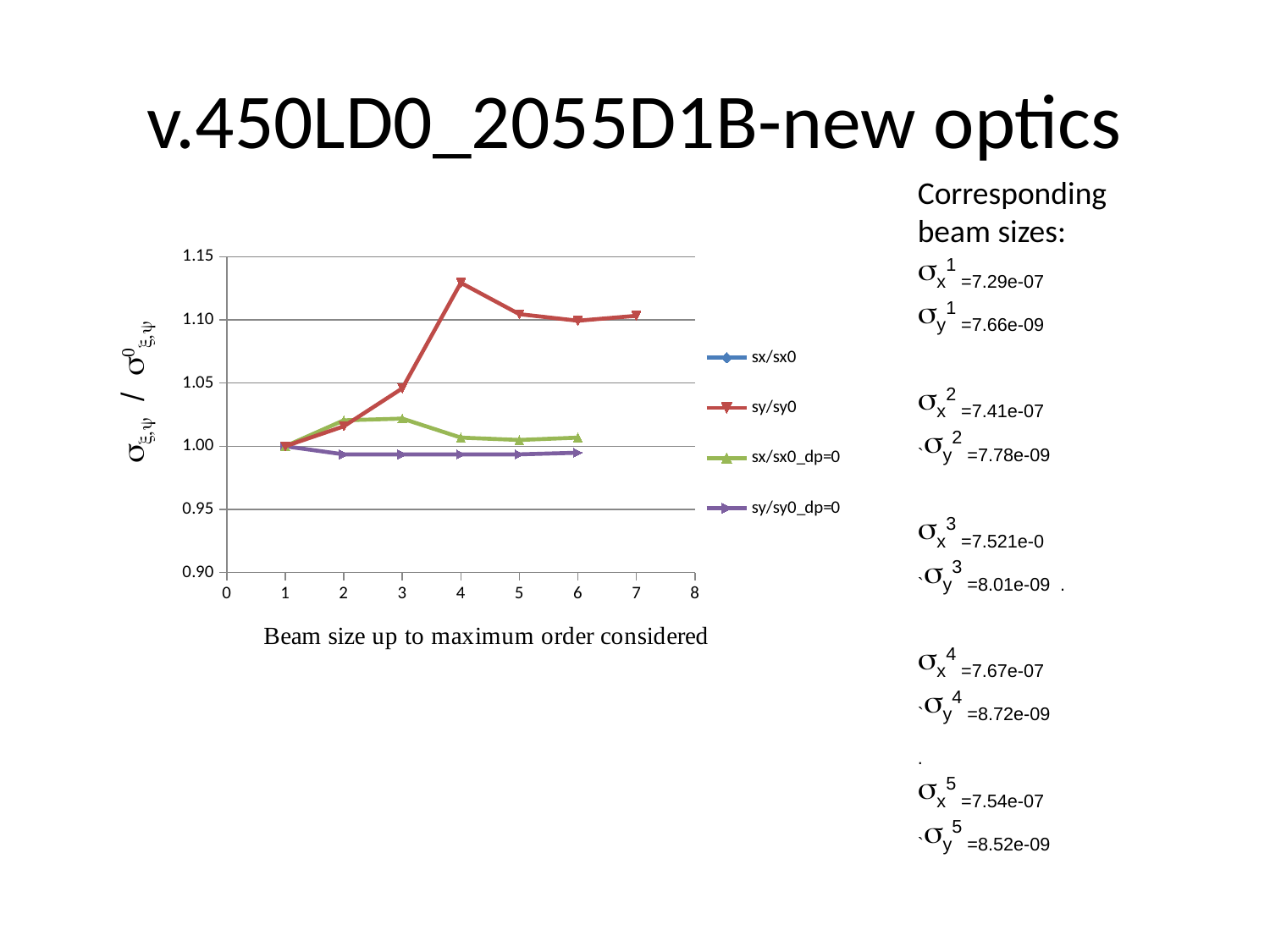
Does the sy/sy0 series rise or fall between x = 1 and x = 4? rise Is the value of sy/sy0 at x = 4 greater or less than 1.10? greater What colour is the sy/sy0 line in the chart? red Which series reaches the highest value on the chart? sy/sy0 At x = 6, which is larger: sx/sx0_dp=0 or sy/sy0_dp=0? sx/sx0_dp=0 Is the value of sy/sy0_dp=0 at x = 5 greater or less than 1.05? less Is the value of sx/sx0_dp=0 at x = 3 greater or less than 1.05? less At x = 4, which is larger: sy/sy0 or sx/sx0_dp=0? sy/sy0 What kind of chart is shown on the slide? line chart How many series does the chart legend list? 4 What is the x-axis title of the chart? Beam size up to maximum order considered